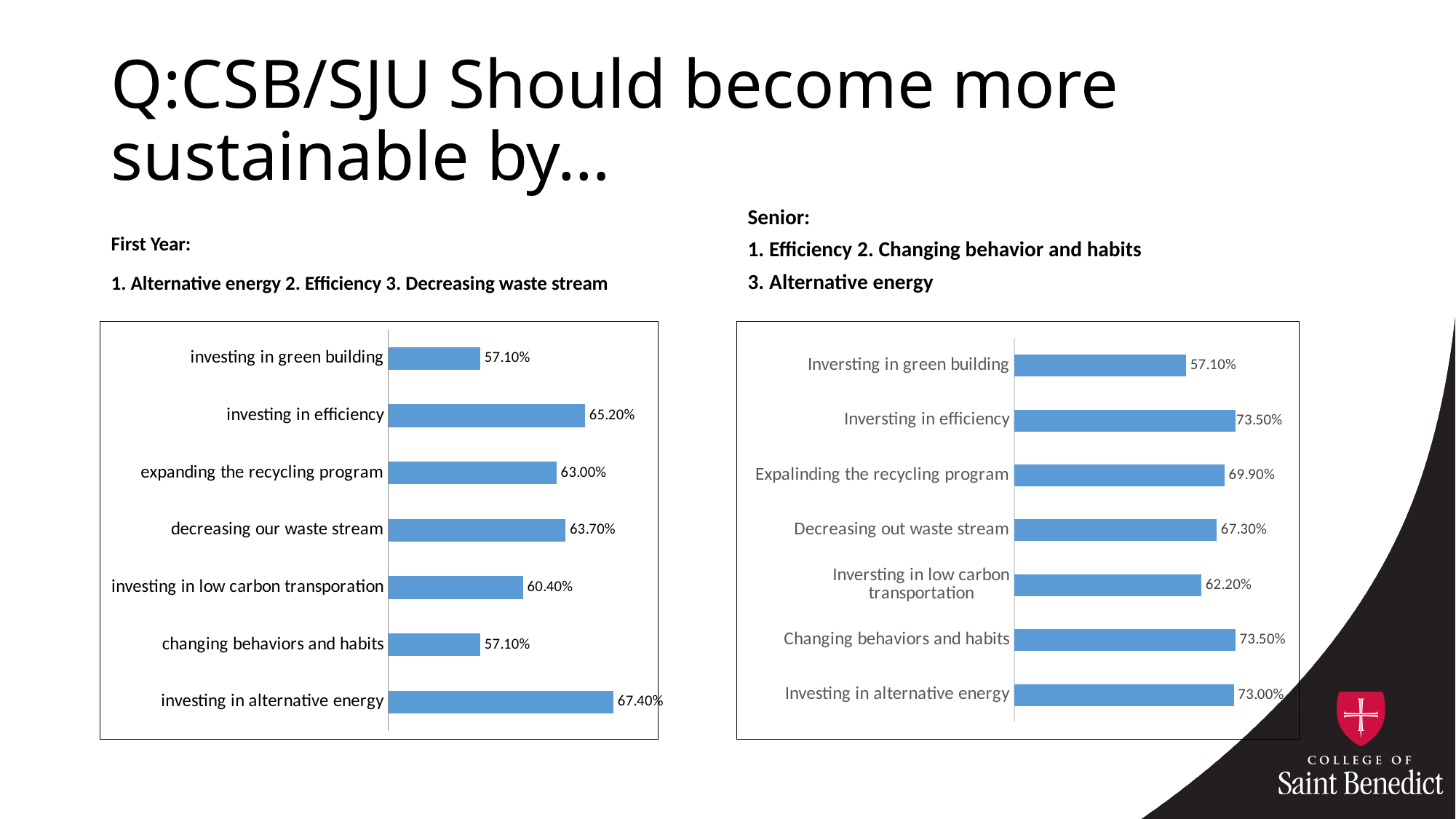
In the left chart (First Year), what is the value for investing in alternative energy? 67.40% In the left chart (First Year), which category has the highest value? investing in alternative energy In the left chart (First Year), which is larger: decreasing our waste stream or investing in low carbon transporation? decreasing our waste stream In the right chart (Senior), what is the difference between Inversting in efficiency and Inversting in low carbon transportation? 11.30% How many categories are shown in the left chart (First Year)? 7 In the right chart (Senior), which is larger: Decreasing out waste stream or Inversting in green building? Decreasing out waste stream In the left chart (First Year), what is the value for changing behaviors and habits? 57.10% In the left chart (First Year), what is the difference between investing in efficiency and investing in green building? 8.10% In the right chart (Senior), what is the value for Expalinding the recycling program? 69.90% In the right chart (Senior), which category has the lowest value? Inversting in green building What kind of chart is the right chart (Senior)? bar chart In the right chart (Senior), what is the value for Changing behaviors and habits? 73.50%